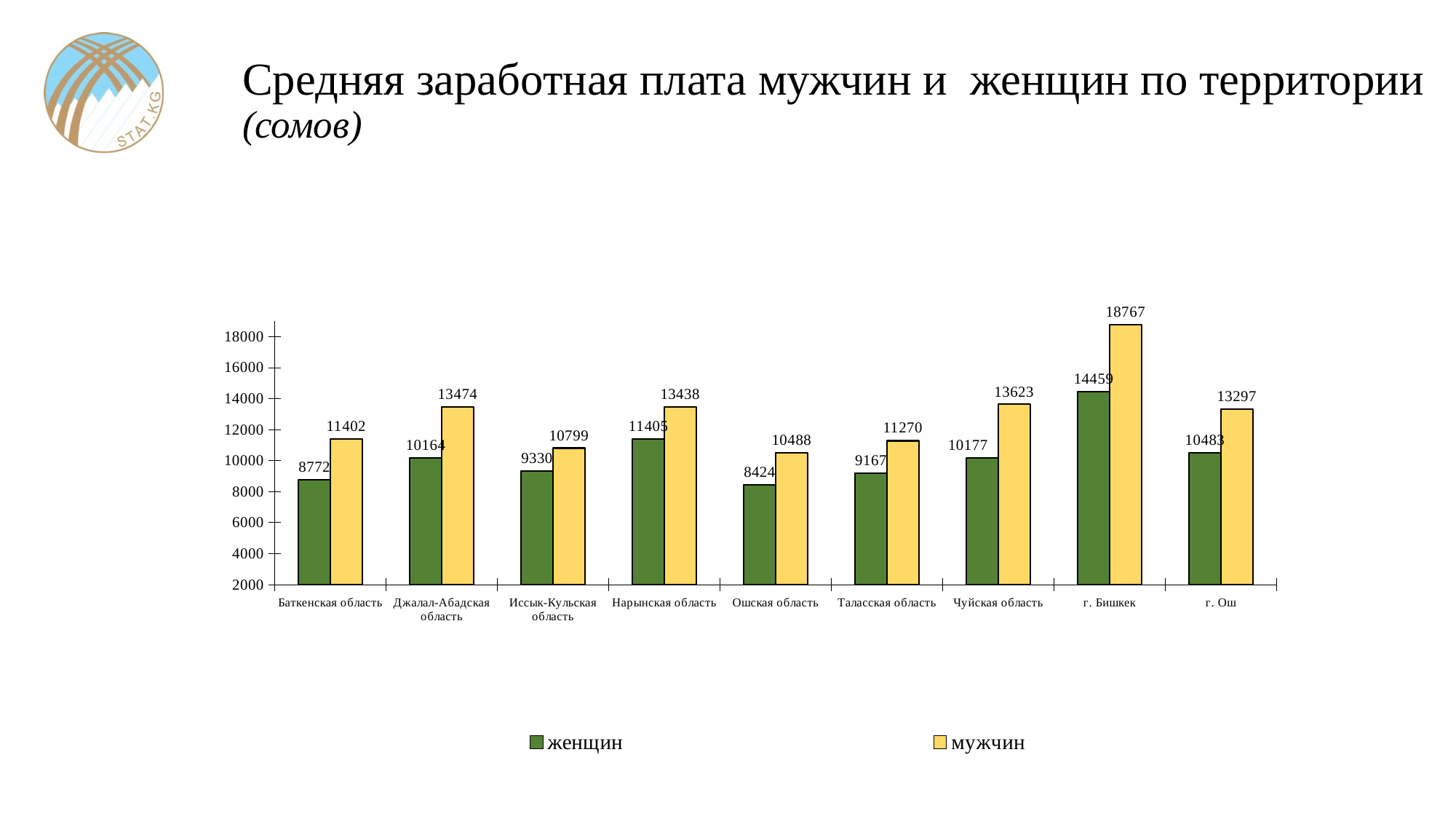
Which is larger: the женщин value in Нарынская область or the женщин value in Чуйская область? Нарынская область What type of chart is shown on the slide? bar chart How many regions (categories) are shown on the x axis? 9 What is the difference between the мужчин and женщин values in Баткенская область? 2630 What is the value for мужчин in Нарынская область? 13438 What is the value for мужчин in г. Ош? 13297 Which region has the lowest value for женщин? Ошская область What is the value for женщин in Баткенская область? 8772 How many series does the legend list? 2 Which region has the highest value for мужчин? г. Бишкек Which colour represents the мужчин series in the chart? yellow What is the difference between the мужчин and женщин values in г. Бишкек? 4308